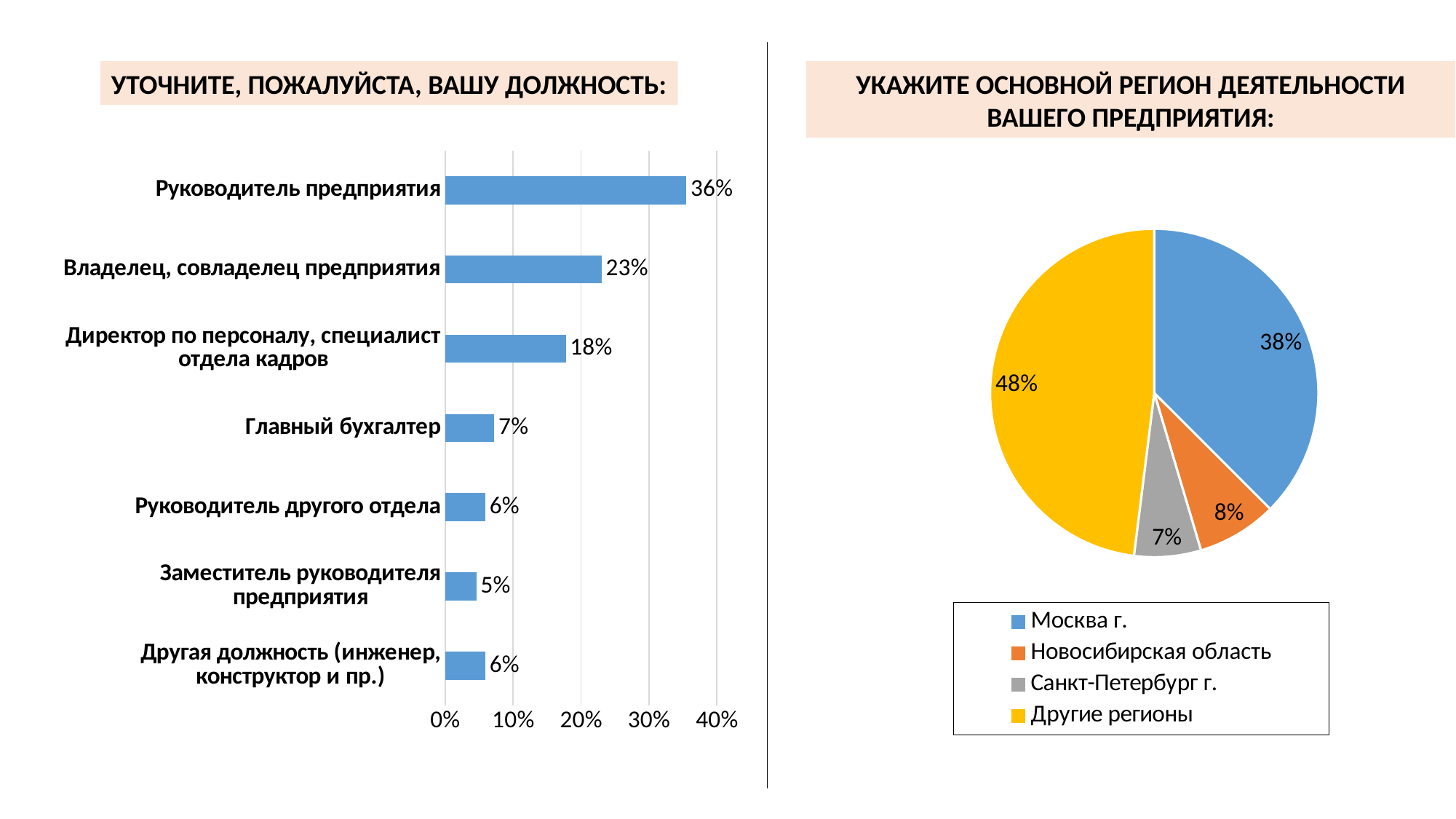
In the bar chart on the left, which is larger: Владелец, совладелец предприятия or Директор по персоналу, специалист отдела кадров? Владелец, совладелец предприятия What kind of chart is on the left side of the slide? Bar chart In the bar chart on the left, which category has the lowest value? Заместитель руководителя предприятия In the bar chart on the left, which category has the highest value? Руководитель предприятия In the pie chart on the right, what share does Москва г. have? 38% In the pie chart on the right, which region has the largest share? Другие регионы In the bar chart on the left, what is the difference between Руководитель предприятия and Владелец, совладелец предприятия? 13% How many entries does the legend of the pie chart on the right list? 4 In the bar chart on the left, what is the value for Главный бухгалтер? 7% In the bar chart on the left, what is the value for Руководитель предприятия? 36% In the pie chart on the right, what colour is the slice for Санкт-Петербург г.? Grey How many categories does the bar chart on the left show? 7